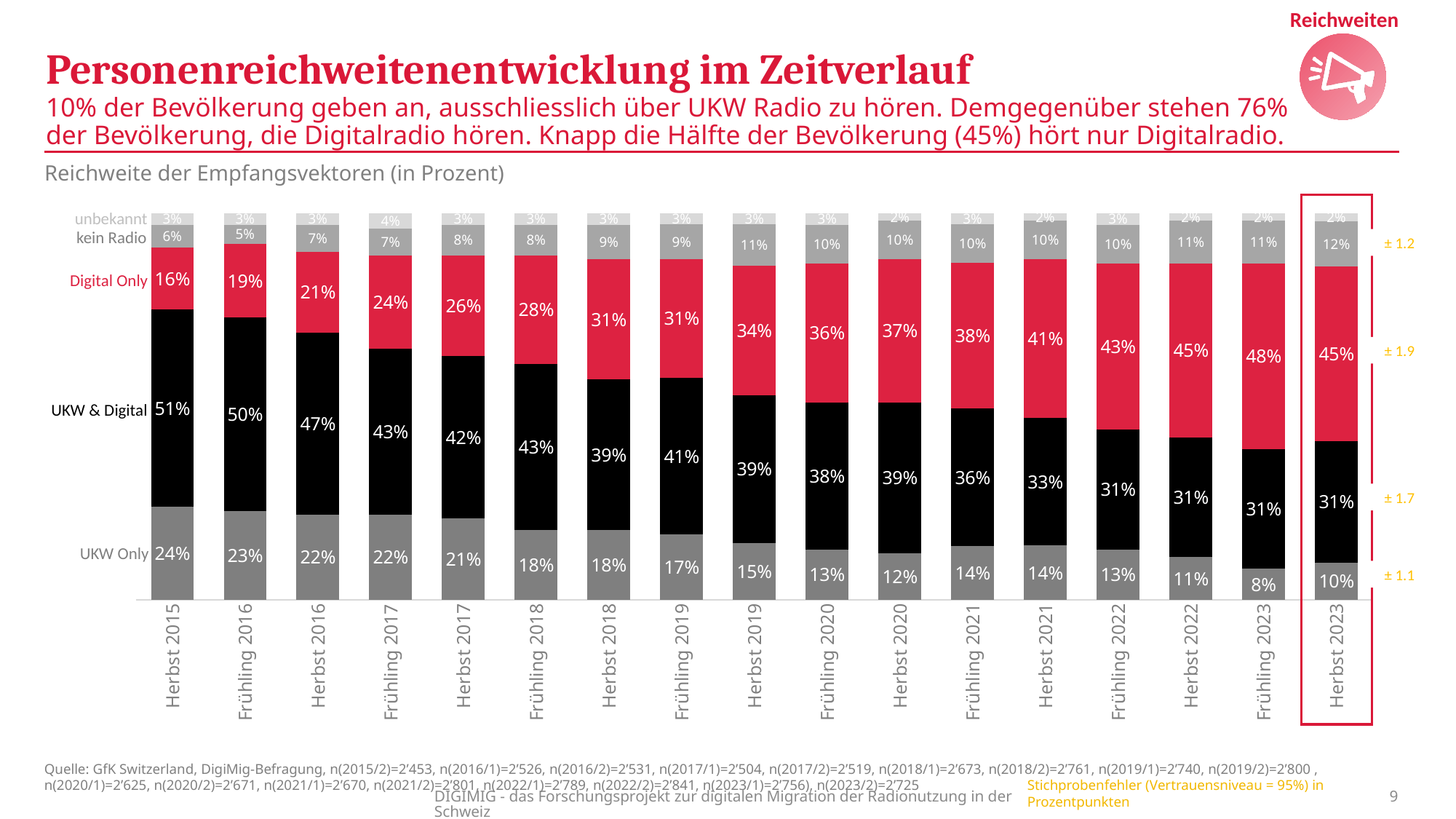
Does the UKW Only share rise or fall from Herbst 2015 to Herbst 2023? Fall What kind of chart is shown? Stacked bar chart What is the value for Digital Only in Herbst 2023? 45% By how many percentage points did UKW & Digital fall from Herbst 2015 to Herbst 2023? 20 percentage points In Herbst 2021, which is larger: Digital Only or UKW & Digital? Digital Only What is the value for kein Radio in Herbst 2019? 11% What is the total of the stacked bar for Herbst 2023? 100% In which period is the UKW Only share lowest? Frühling 2023 How many periods are shown on the x axis? 17 How many series are stacked in each bar? 5 In which period is the Digital Only share highest? Frühling 2023 What is the value for UKW Only in Herbst 2015? 24%